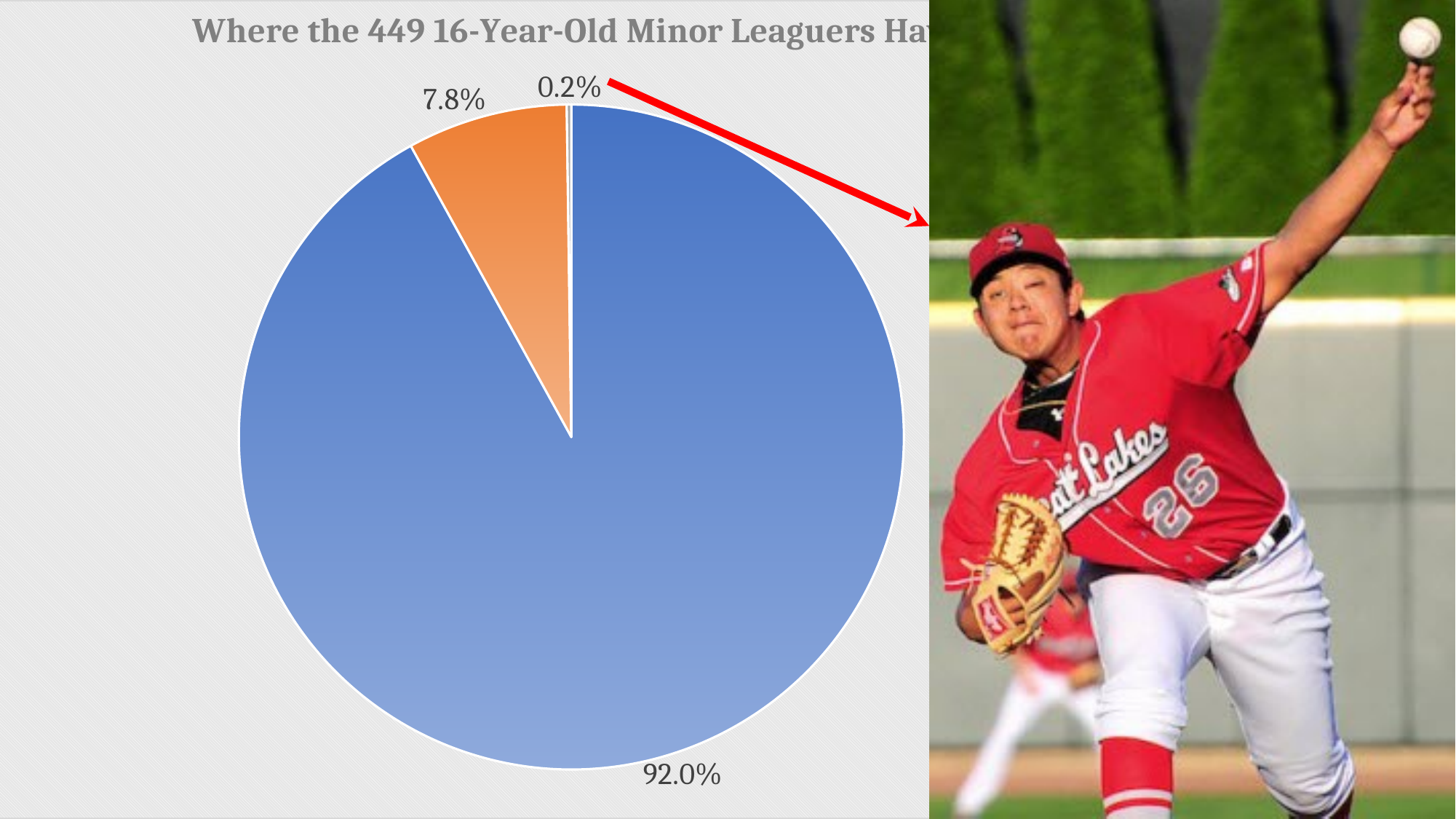
Which slice is larger, the orange slice or the slice labelled 0.2%? the orange slice How many 16-year-old minor leaguers does the chart title say it covers? 449 What is the value of the largest slice of the pie chart? 92.0% How many slices does the pie chart have? 3 What value is labelled on the orange slice of the pie chart? 7.8% What is the value of the smallest slice of the pie chart? 0.2% What is the difference between the largest slice (92.0%) and the orange slice (7.8%)? 84.2% What is the difference between the orange slice (7.8%) and the smallest slice (0.2%)? 7.6% What do the three slice values of the pie chart add up to? 100.0% What kind of chart is shown on the slide? pie chart What colour is the largest slice of the pie chart? blue Is the largest slice of the pie chart greater or less than 50%? greater